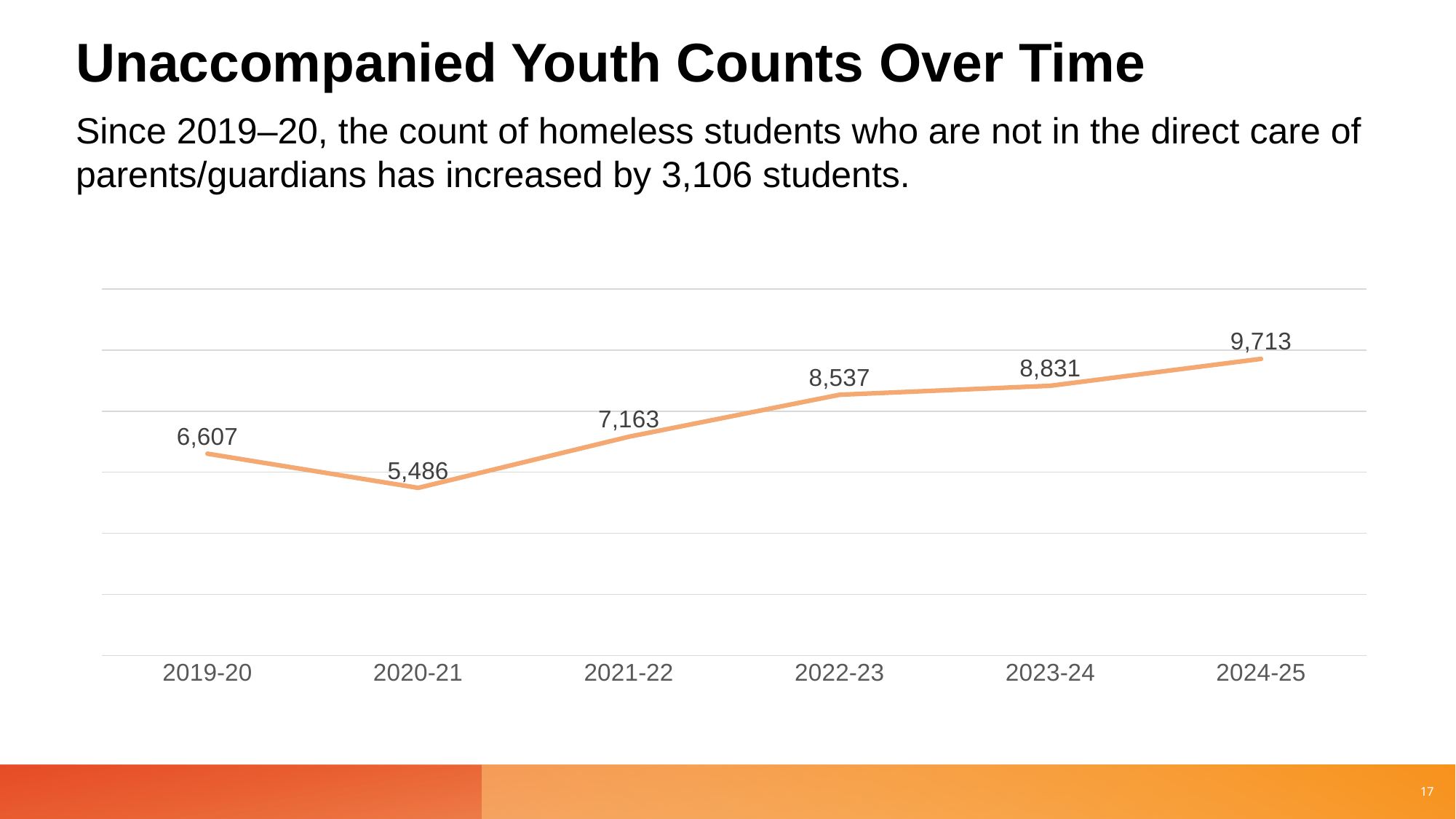
Which school year has the lowest unaccompanied youth count? 2020-21 What is the unaccompanied youth count for 2022-23? 8,537 From 2020-21 to 2024-25, do the values rise or fall? Rise How many school years are plotted on the chart? 6 What kind of chart is shown on the slide? Line chart Which is larger, the count for 2021-22 or the count for 2020-21? 2021-22 What is the unaccompanied youth count for 2020-21? 5,486 What is the unaccompanied youth count for 2024-25? 9,713 What is the difference between the 2023-24 count and the 2022-23 count? 294 Which school year has the highest unaccompanied youth count? 2024-25 What is the difference between the 2024-25 count and the 2019-20 count? 3,106 What is the unaccompanied youth count for 2019-20? 6,607